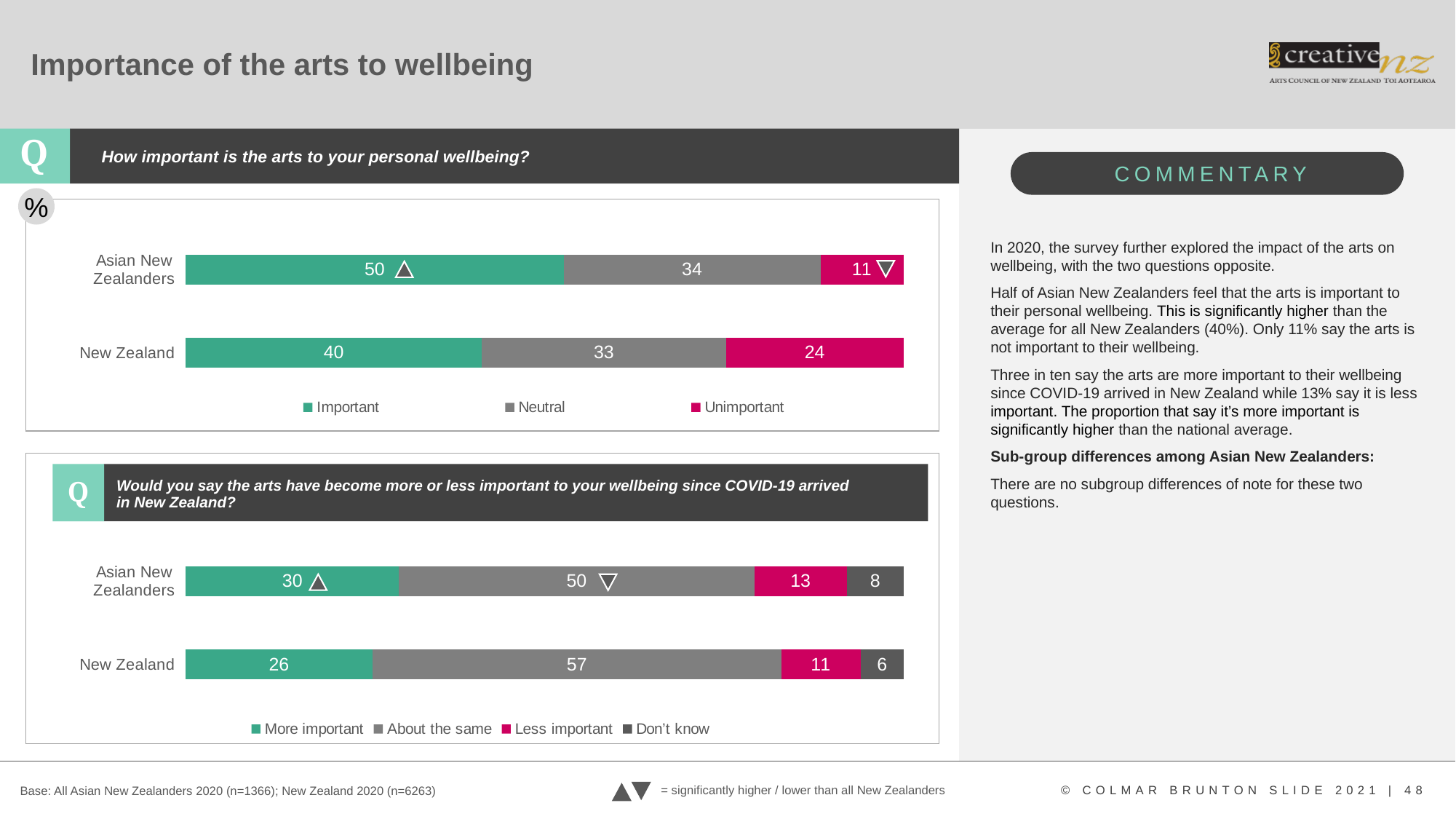
In the top chart, what is the difference between the Important values for Asian New Zealanders and New Zealand? 10 What type of chart is the bottom chart? Stacked bar chart In the top chart, what is the Unimportant value for New Zealand? 24 In the bottom chart (arts more or less important since COVID-19), what percentage of Asian New Zealanders say More important? 30 In the bottom chart, what is the About the same value for New Zealand? 57 In the top chart (How important is the arts to your personal wellbeing?), what percentage of Asian New Zealanders say the arts are Important? 50 In the bottom chart, what is the Don't know value for Asian New Zealanders? 8 In the top chart, what is the Neutral value for Asian New Zealanders? 34 How many series does the legend of the top chart list? 3 How many series does the legend of the bottom chart list? 4 In the top chart, which group has the larger Unimportant value, Asian New Zealanders or New Zealand? New Zealand In the bottom chart, what is the difference between the Less important values for Asian New Zealanders and New Zealand? 2